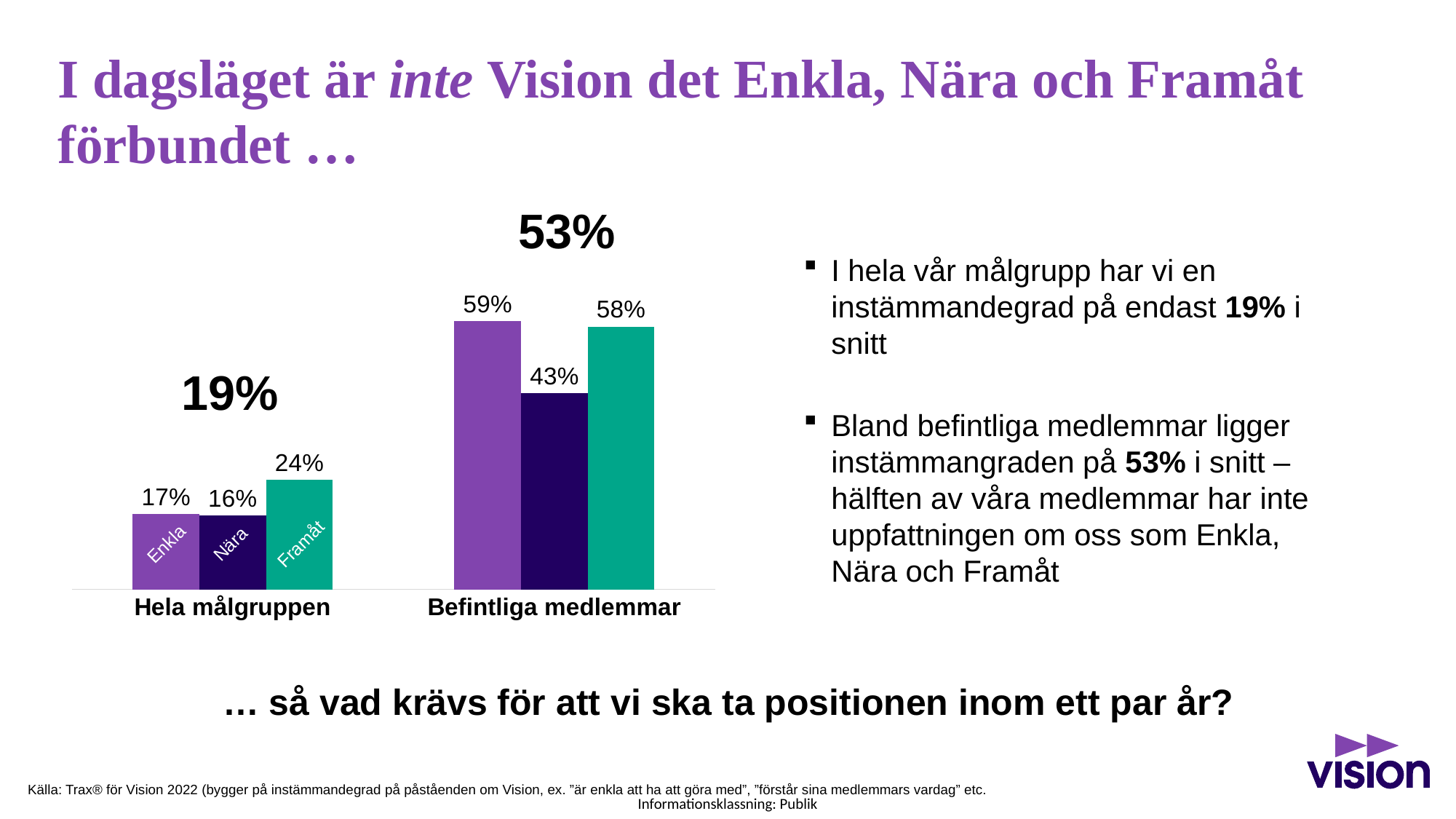
How many category groups are shown on the x axis of the chart? 2 What is the value for Nära in the Befintliga medlemmar group? 43% What is the value for Enkla in the Hela målgruppen group? 17% Which series has the lowest value in the Befintliga medlemmar group? Nära Which is larger: Framåt for Hela målgruppen or Nära for Befintliga medlemmar? Nära for Befintliga medlemmar Which series has the highest value in the Hela målgruppen group? Framåt What is the difference between the Enkla values for Befintliga medlemmar and Hela målgruppen? 42% What kind of chart is shown on the slide? Bar chart What is the value for Enkla in the Befintliga medlemmar group? 59% What average percentage is printed above the Befintliga medlemmar group? 53% How many series (bars per group) does the chart show? 3 What is the value for Framåt in the Hela målgruppen group? 24%